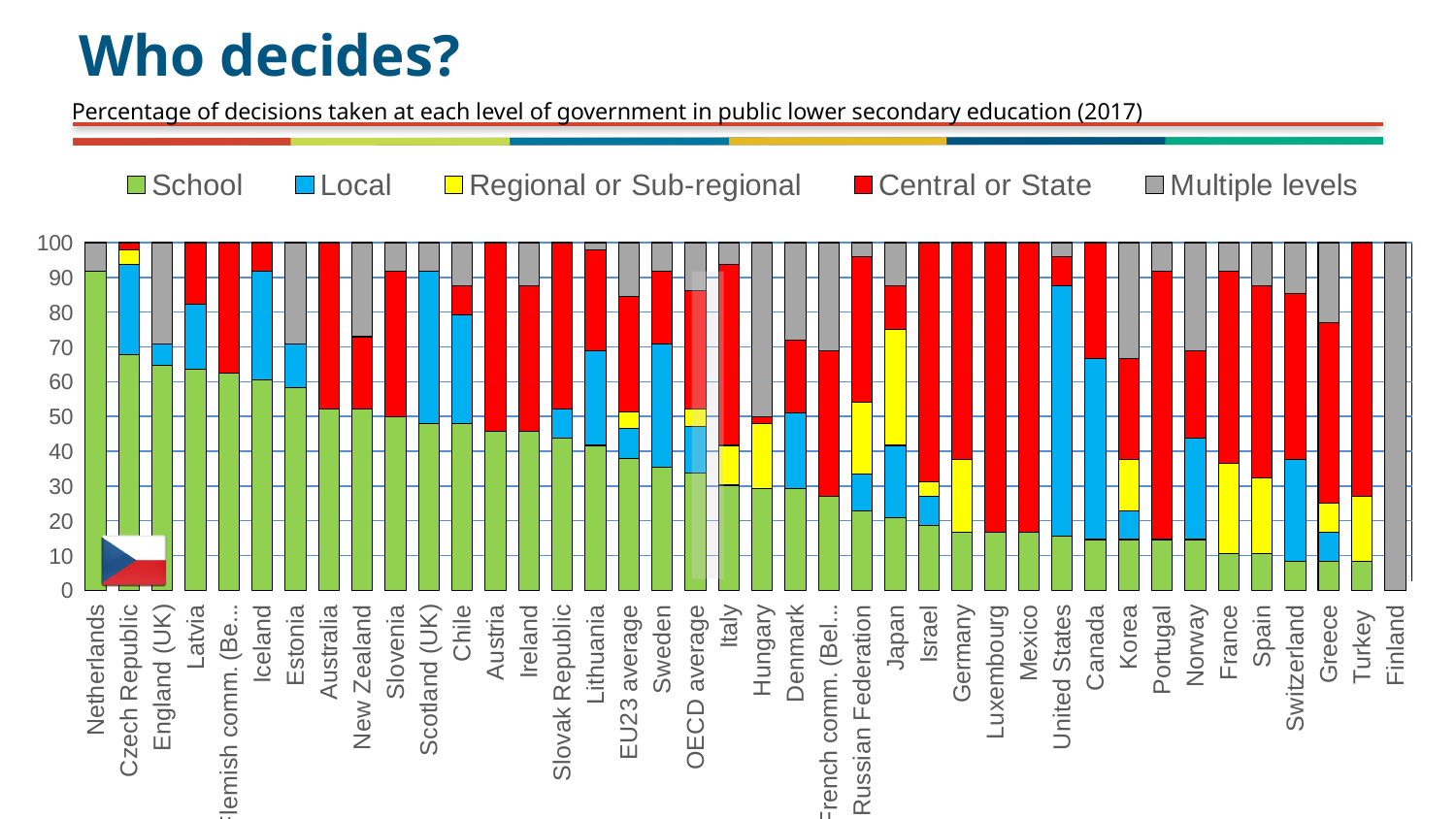
Is the School value for Japan greater or less than 30? less Is the School value for Netherlands greater or less than 80? greater Does the School share generally rise or fall moving from left to right along the x axis? fall How many series does the legend list? 5 Which colour represents the Central or State series in the legend? Red Which has a larger School share, Czech Republic or Turkey? Czech Republic How many countries or categories are shown along the x axis? 40 Is the School value for Turkey greater or less than 20? less Which has a larger School share, Netherlands or Finland? Netherlands What kind of chart is shown on the slide? Stacked bar chart Which category has the largest School share? Netherlands Which category's bar consists entirely of the Multiple levels series? Finland